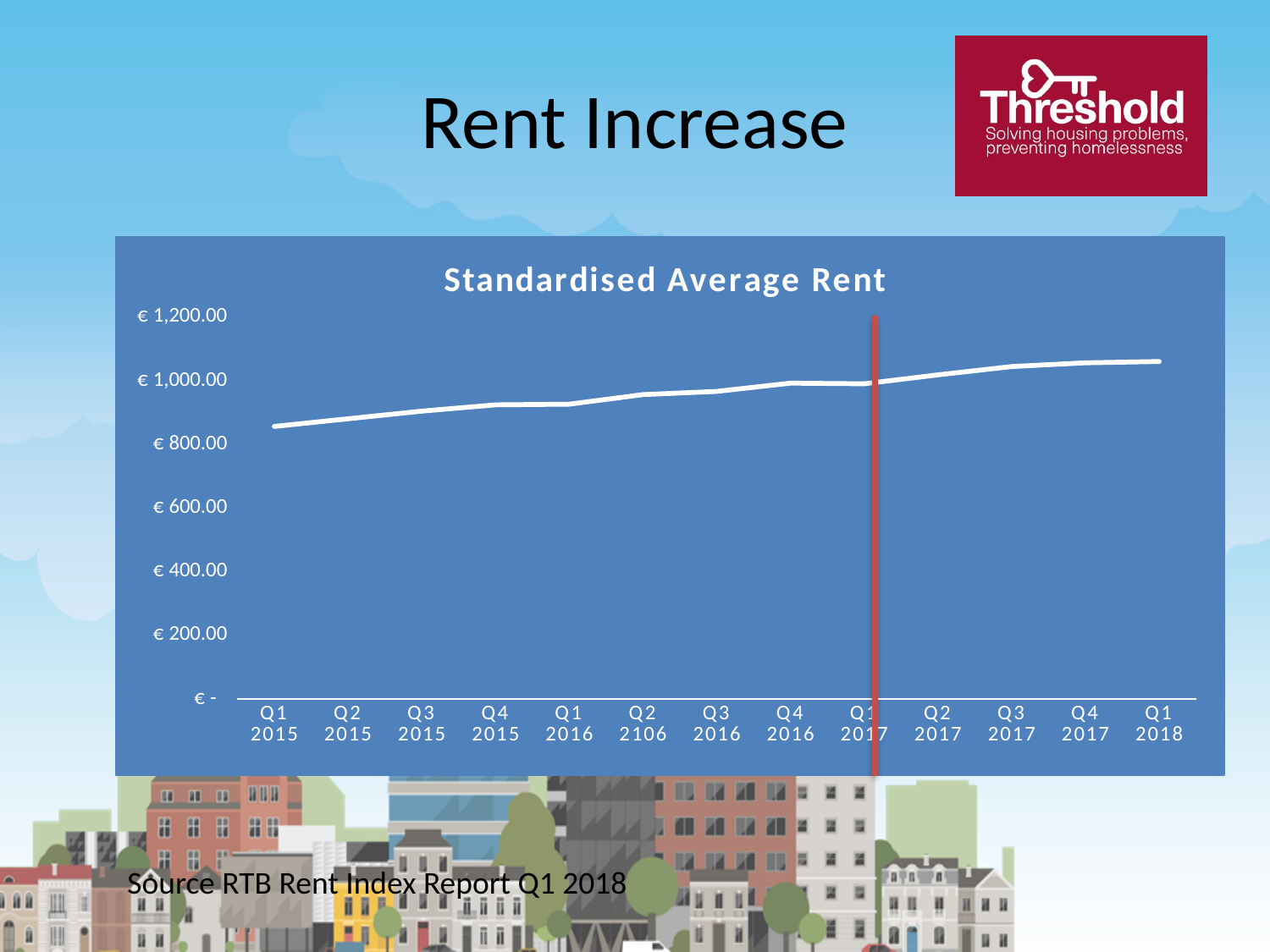
Which quarter has the lowest standardised average rent? Q1 2015 Is the value for Q1 2015 greater or less than € 800.00? greater What type of chart is shown on the slide? Line chart Which is larger, the value for Q1 2018 or the value for Q1 2015? Q1 2018 Is the value for Q1 2018 greater or less than € 1,000.00? greater Do the standardised average rent values rise or fall from Q1 2015 to Q1 2018? Rise What is the title of the chart? Standardised Average Rent Is the value for Q1 2015 greater or less than € 1,000.00? less How many quarterly data points are plotted on the chart? 13 At which quarter on the x axis is the red vertical line drawn? Q1 2017 Which quarter has the highest standardised average rent? Q1 2018